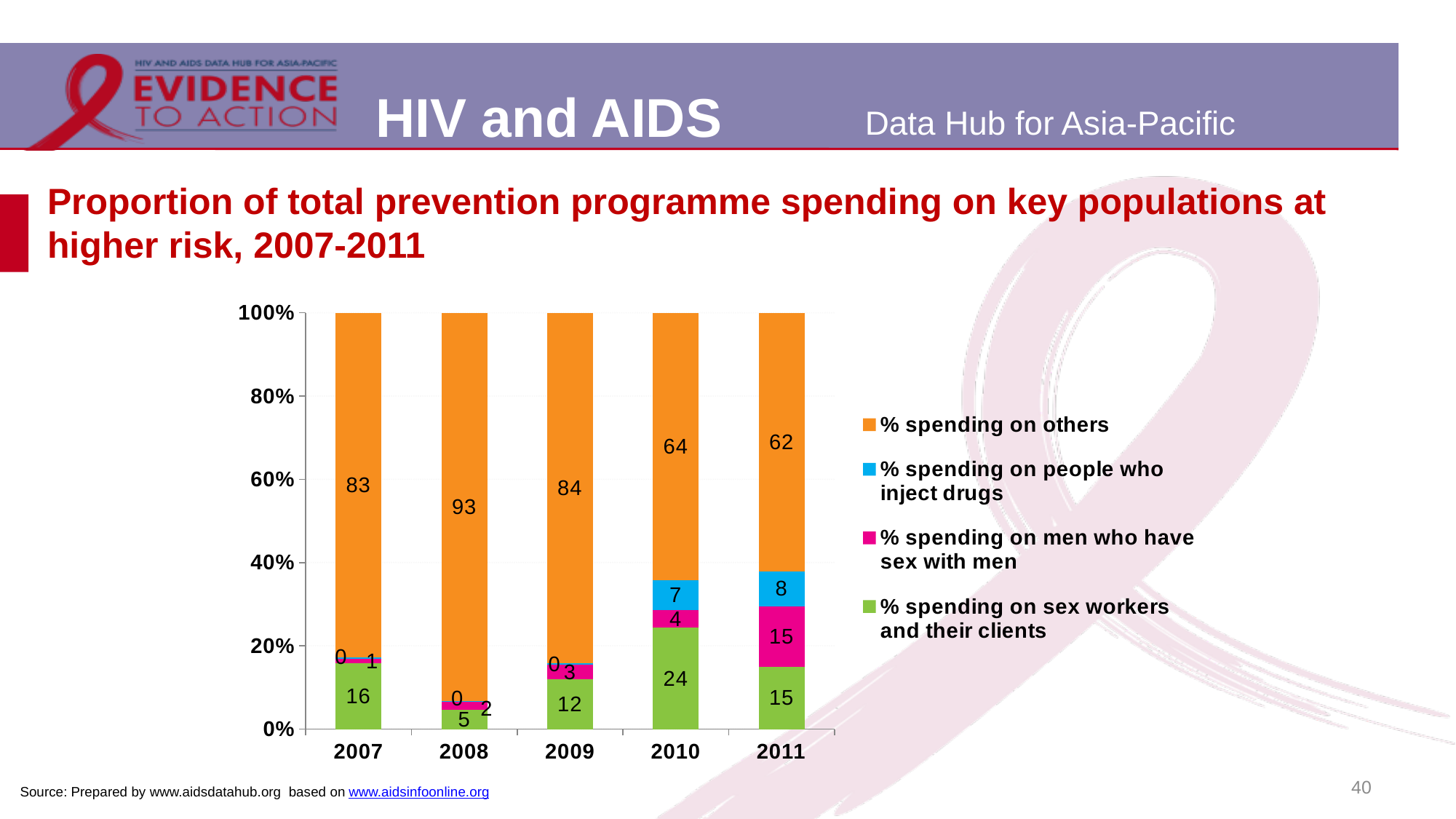
What is the % spending on men who have sex with men in 2009? 3 Which is larger: the % spending on men who have sex with men in 2010 or in 2011? 2011 In which year is the % spending on others highest? 2008 What is the % spending on others in 2008? 93 Does the % spending on others fall or rise from 2009 to 2011? Fall What is the difference between the % spending on others in 2007 and in 2011? 21 What kind of chart is shown on the slide? Stacked bar chart In which year is the % spending on sex workers and their clients lowest? 2008 How many years are shown on the x axis? 5 What is the % spending on people who inject drugs in 2011? 8 How many series does the legend list? 4 What is the % spending on sex workers and their clients in 2010? 24